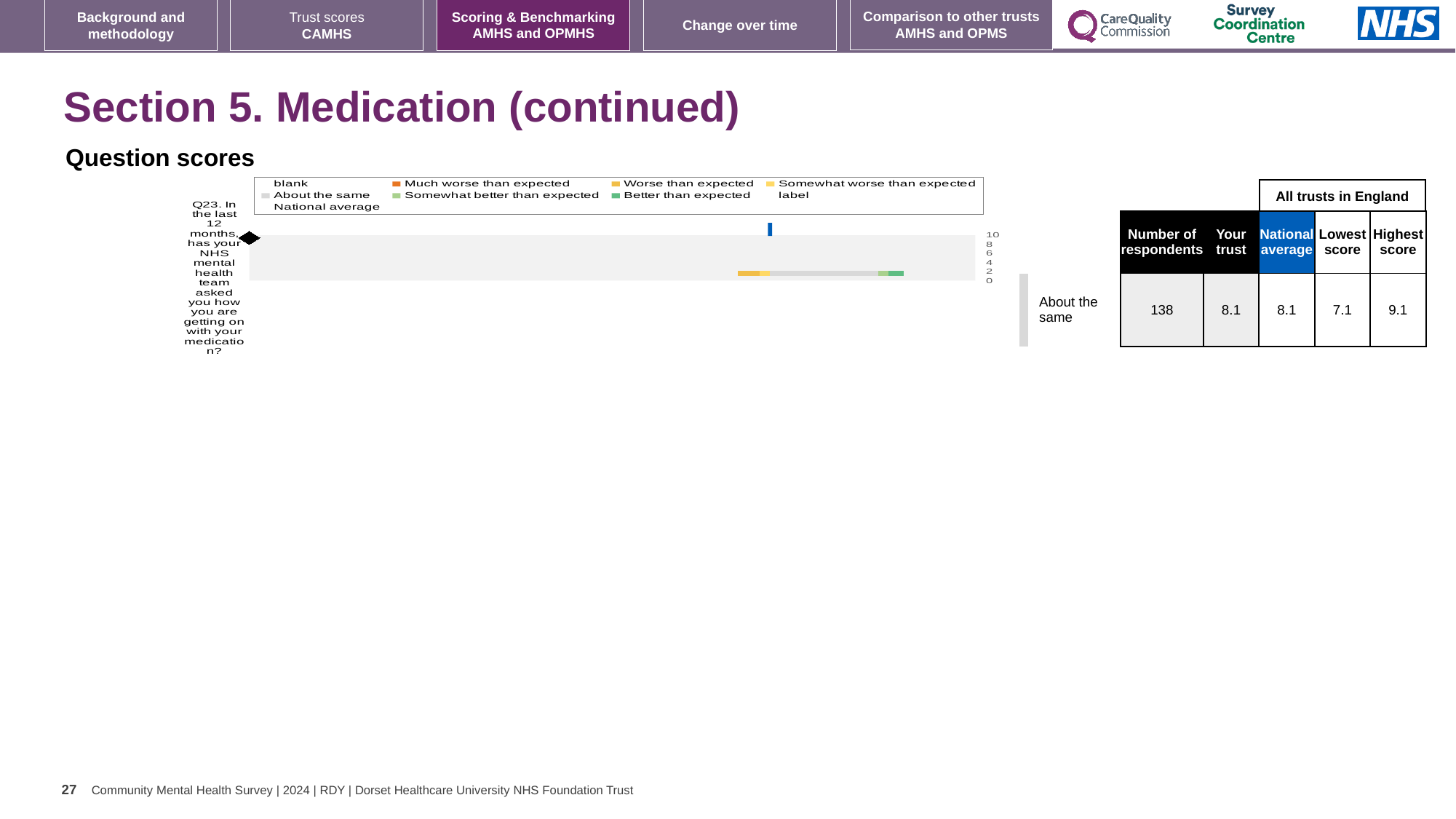
How many survey questions are plotted in the chart? 1 How many respondents answered Q23, according to the table beside the chart? 138 What is the difference between the highest score and the lowest score for Q23 in the table beside the chart? 2.0 In the table beside the chart, what is the 'Your trust' score for Q23? 8.1 In the table beside the chart, what is the lowest score among all trusts in England for Q23? 7.1 What benchmark category is the trust's Q23 result placed in, as labelled next to the chart? About the same What is the question label shown on the chart's category axis? Q23. In the last 12 months, has your NHS mental health team asked you how you are getting on with your medication? What kind of chart is used to show the Q23 question score? bar chart In the table beside the chart, what is the highest score among all trusts in England for Q23? 9.1 Which legend entry is shown in orange in the chart? Much worse than expected Which is larger for Q23: the highest score among all trusts or the 'Your trust' score? Highest score In the table beside the chart, what is the national average score for Q23? 8.1